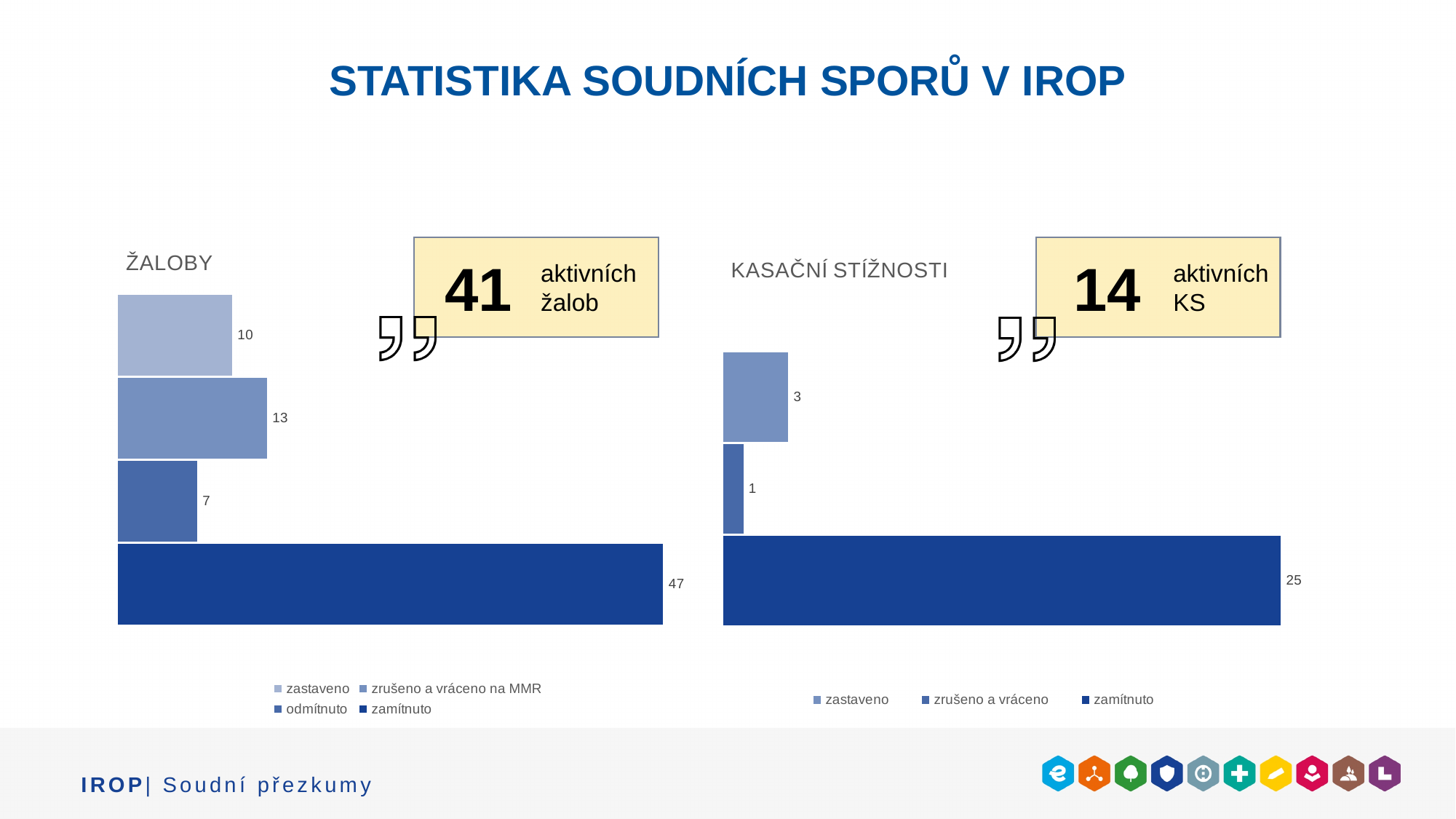
In the ŽALOBY chart, what is the value for odmítnuto? 7 How many series does the legend of the KASAČNÍ STÍŽNOSTI chart list? 3 In the KASAČNÍ STÍŽNOSTI chart, which is larger, zastaveno or zrušeno a vráceno? zastaveno In the ŽALOBY chart, what is the difference between zamítnuto and zastaveno? 37 In the ŽALOBY chart, what is the value for zrušeno a vráceno na MMR? 13 In the KASAČNÍ STÍŽNOSTI chart, what is the value for zastaveno? 3 In the ŽALOBY chart, which series has the lowest value? odmítnuto In the KASAČNÍ STÍŽNOSTI chart, which series has the highest value? zamítnuto In the KASAČNÍ STÍŽNOSTI chart, what is the value for zamítnuto? 25 In the ŽALOBY chart, what is the value for zamítnuto? 47 How many series does the legend of the ŽALOBY chart list? 4 What kind of chart is the KASAČNÍ STÍŽNOSTI chart? bar chart